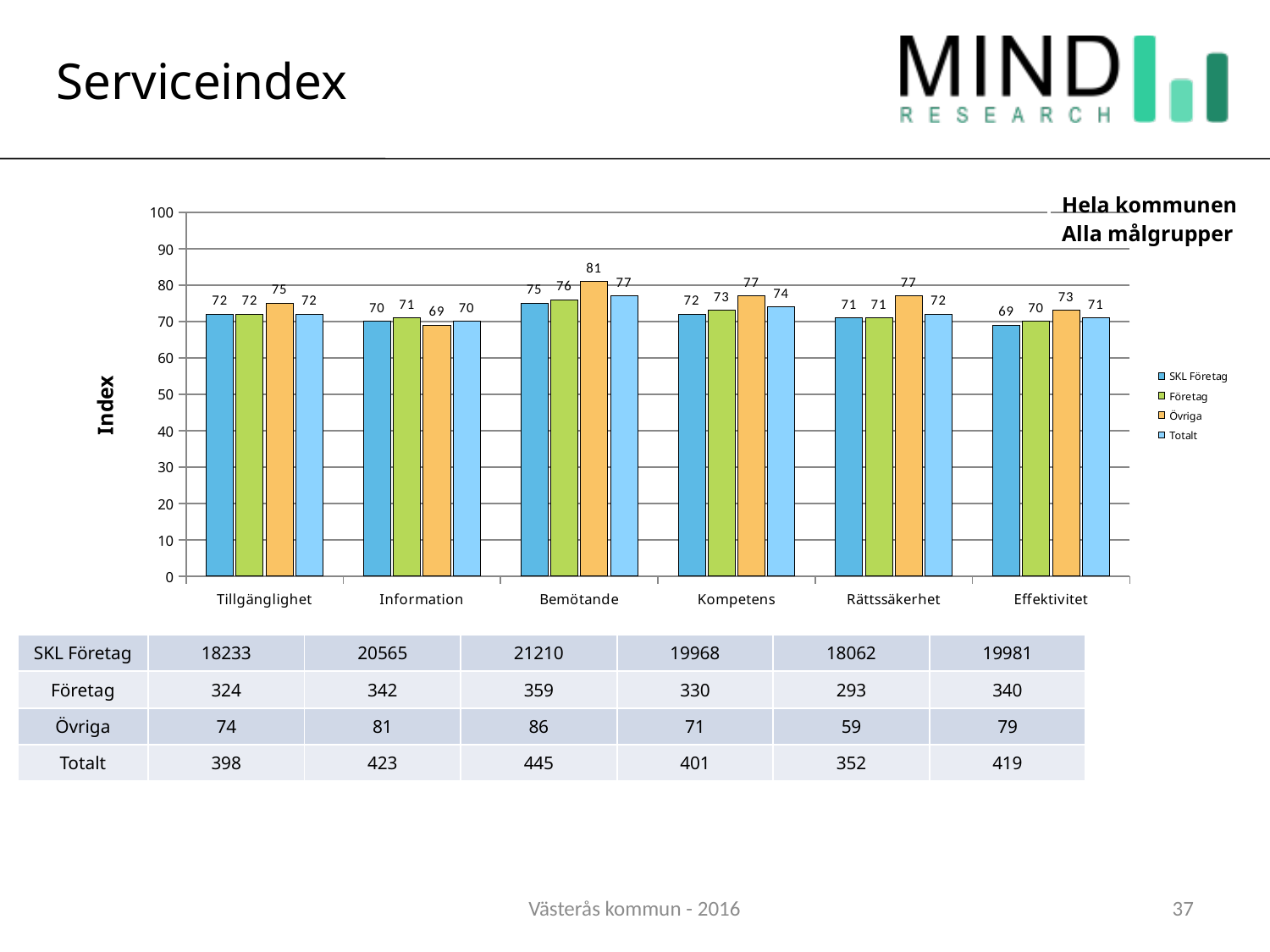
Which category has the lowest value for the Totalt series? Information What is the value for Övriga in the Bemötande category? 81 How many categories are shown on the x axis of the chart? 6 What is the value for Totalt in the Kompetens category? 74 What kind of chart is shown on the slide? bar chart Which category has the highest value for the Övriga series? Bemötande Which is larger: the Övriga value for Rättssäkerhet or the Övriga value for Effektivitet? Rättssäkerhet What is the label on the vertical axis of the chart? Index How many series does the chart legend list? 4 Is the value for Övriga in the Bemötande category greater or less than 80? greater What is the value for SKL Företag in the Effektivitet category? 69 What is the difference between the Övriga value and the SKL Företag value in the Bemötande category? 6